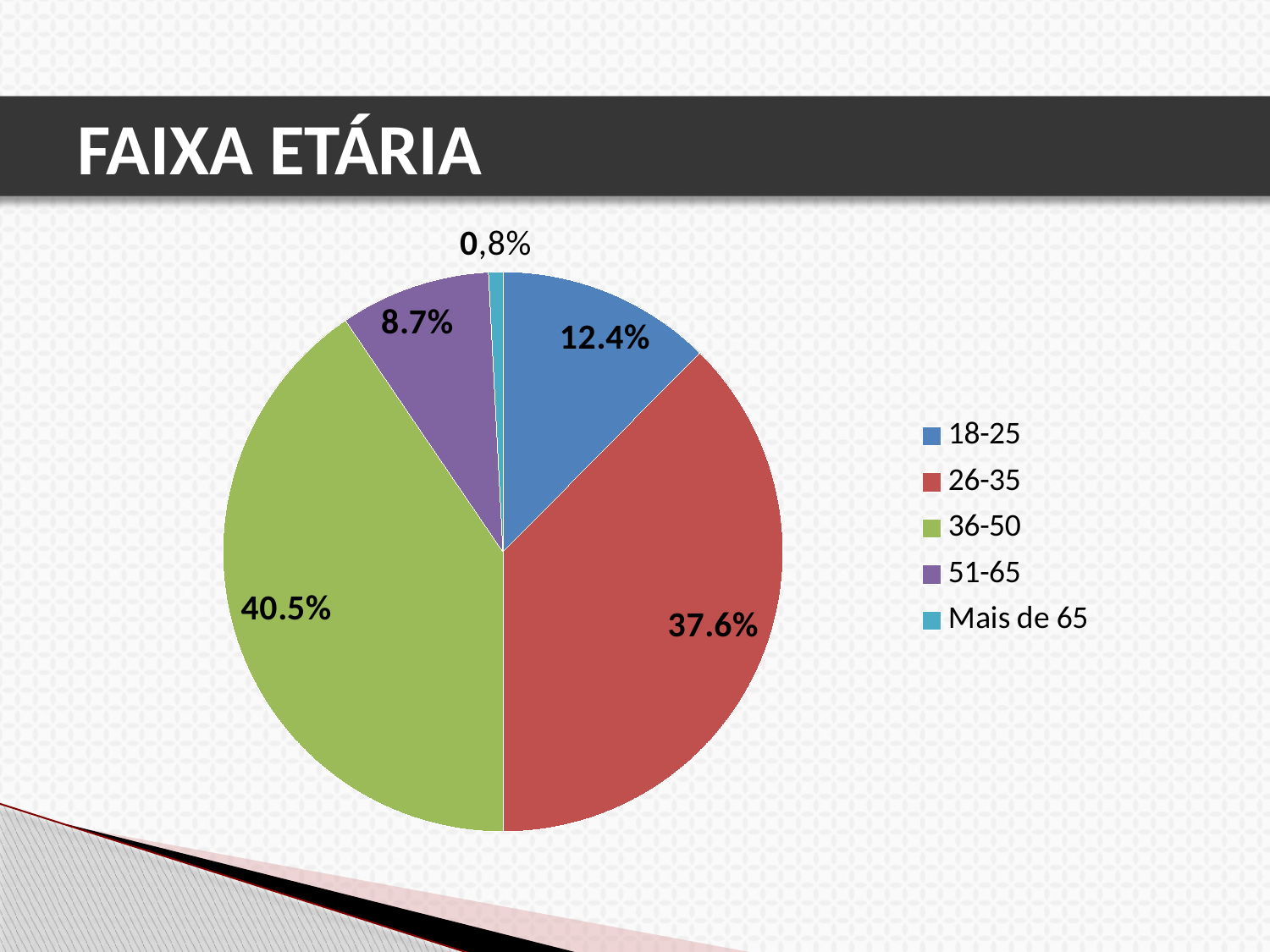
Which slice is larger, 18-25 or 51-65? 18-25 What share of the pie does the 'Mais de 65' group have? 0,8% How many age groups are shown in the pie chart? 5 What type of chart is shown on the slide? Pie chart What share of the pie does the 26-35 age group have? 37.6% Which age group has the smallest share of the pie? Mais de 65 What share of the pie does the 18-25 age group have? 12.4% What is the difference in percentage points between the 36-50 and 26-35 slices? 2.9 What share of the pie does the 51-65 age group have? 8.7% What is the difference in percentage points between the 18-25 and 51-65 slices? 3.7 Which age group has the largest share of the pie? 36-50 What share of the pie does the 36-50 age group have? 40.5%